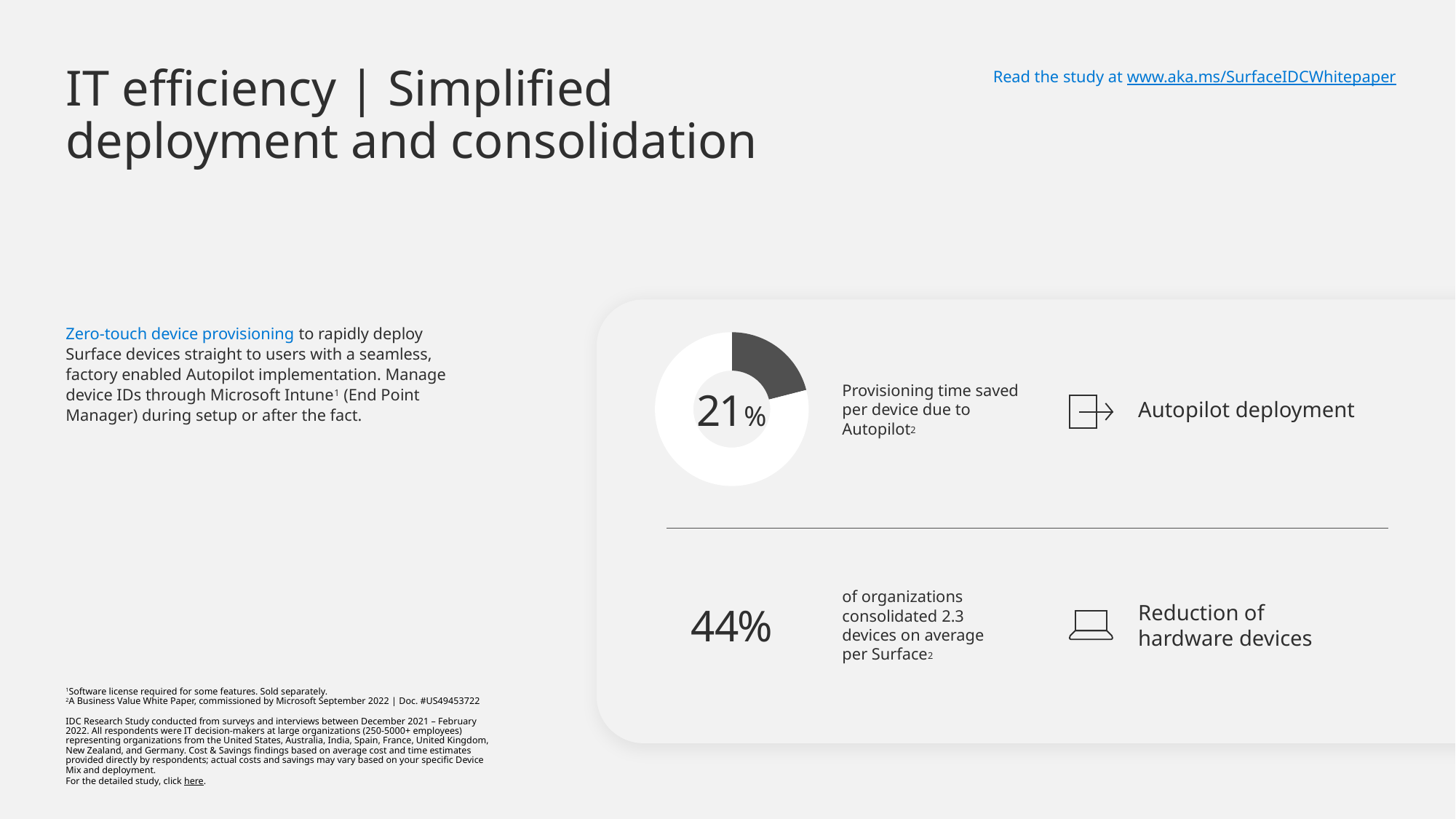
What share of the donut chart is taken up by the dark filled segment? 21% What colour is the filled segment of the donut chart? Dark grey Is the filled segment of the donut chart greater or less than half of the ring? less What does the 21% in the donut chart represent? Provisioning time saved per device due to Autopilot What kind of chart is shown next to the text 'Provisioning time saved per device due to Autopilot'? Donut (pie) chart In the donut chart, which is larger: the dark filled segment or the white remaining portion? The white remaining portion What percentage does the donut chart on the slide display? 21%